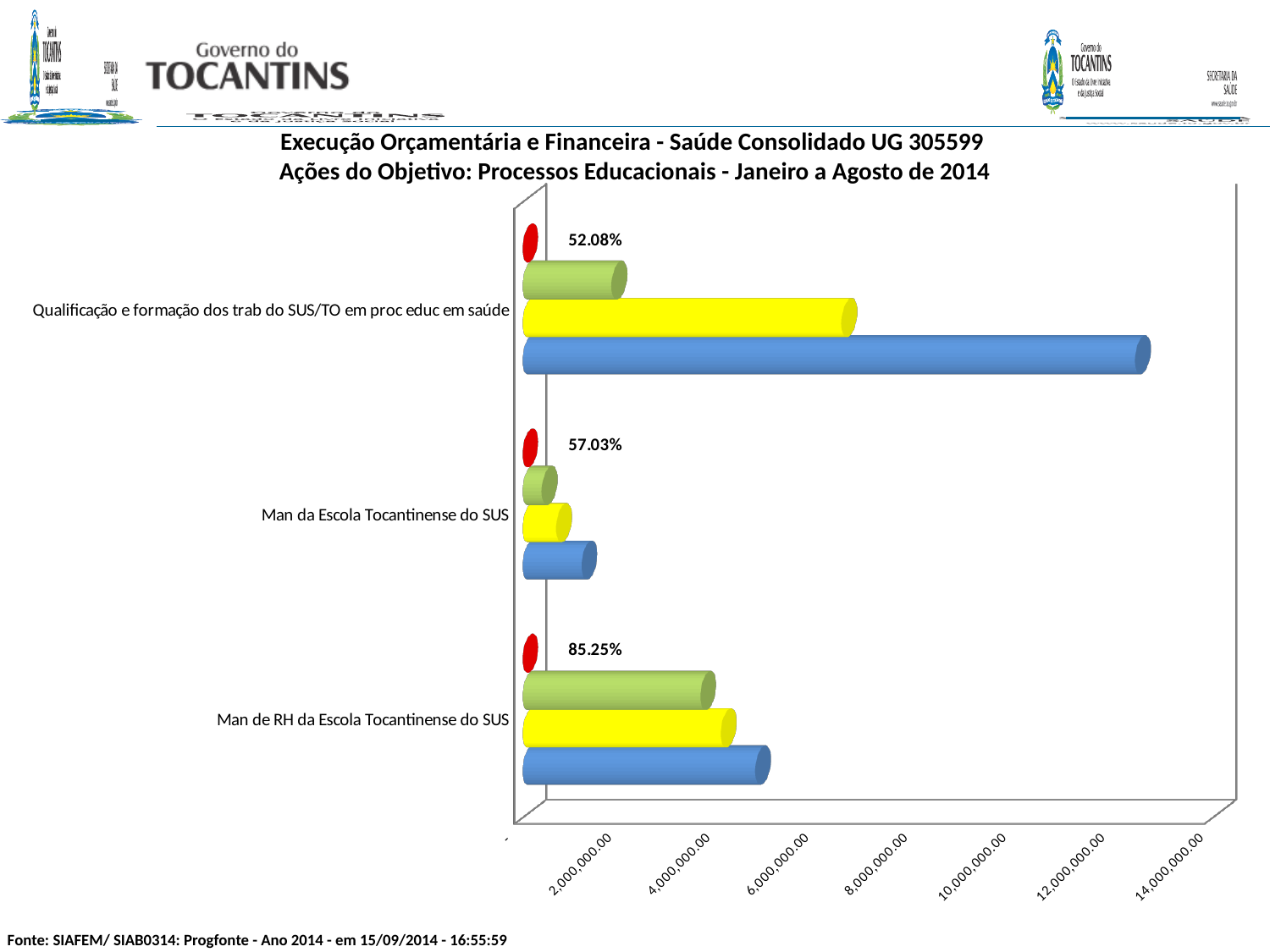
Is the blue bar for "Man da Escola Tocantinense do SUS" greater or less than 2,000,000.00? less Which category has the lowest percentage label? Qualificação e formação dos trab do SUS/TO em proc educ em saúde What percentage is shown for "Man da Escola Tocantinense do SUS"? 57.03% How many categories (actions) are plotted on the chart? 3 What is the first line of the chart title? Execução Orçamentária e Financeira - Saúde Consolidado UG 305599 Is the blue bar for "Qualificação e formação dos trab do SUS/TO em proc educ em saúde" greater or less than 12,000,000.00? greater Which category has the highest percentage label? Man de RH da Escola Tocantinense do SUS What is the difference in percentage points between the labels for "Man de RH da Escola Tocantinense do SUS" and "Qualificação e formação dos trab do SUS/TO em proc educ em saúde"? 33.17 What kind of chart is shown on the slide? bar chart What percentage is shown for "Man de RH da Escola Tocantinense do SUS"? 85.25% Which category has the longest blue bar? Qualificação e formação dos trab do SUS/TO em proc educ em saúde What percentage is shown for "Qualificação e formação dos trab do SUS/TO em proc educ em saúde"? 52.08%